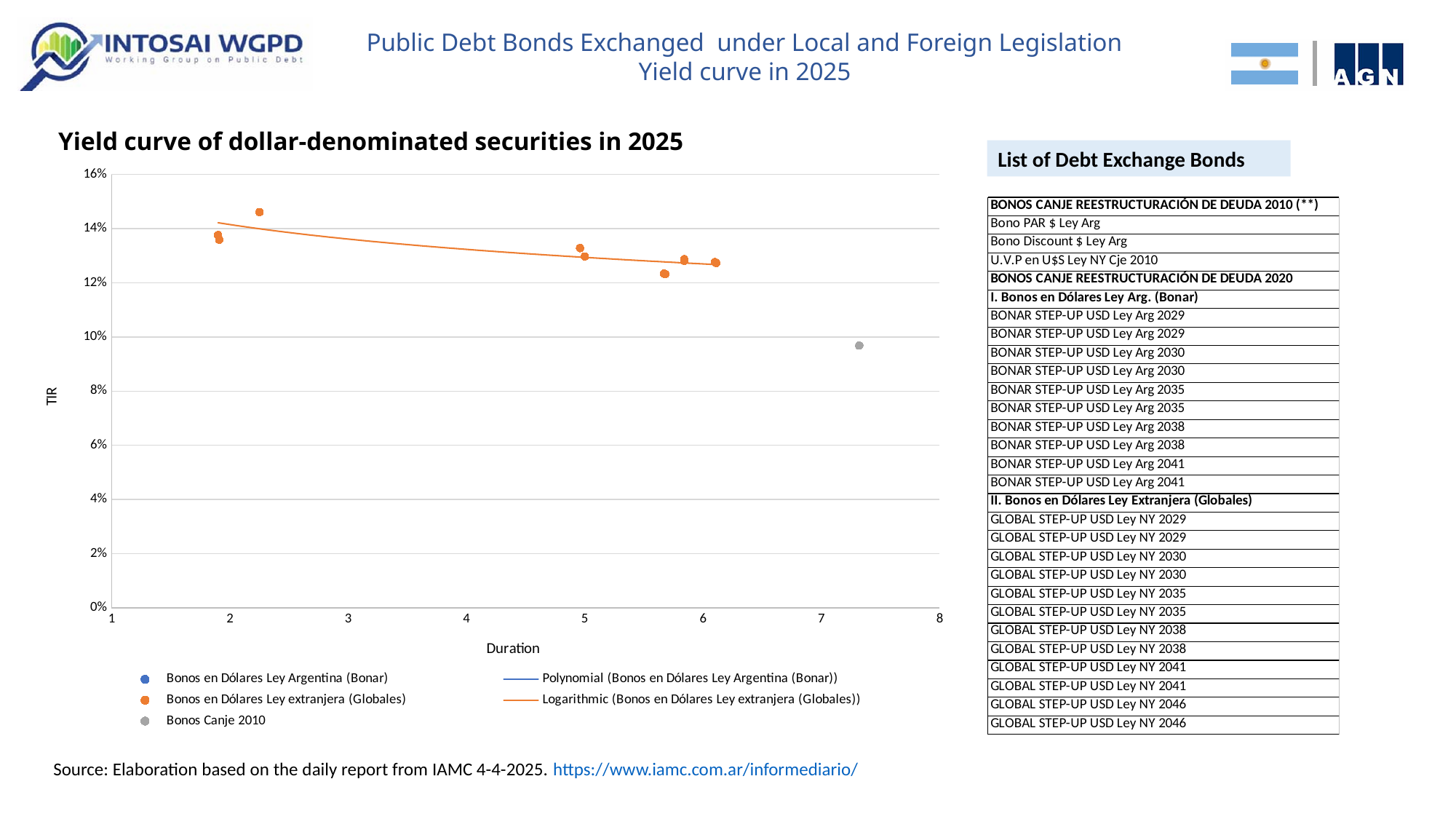
What colour are the Bonos en Dólares Ley extranjera (Globales) points in the chart? Orange Which has a higher TIR: the Bonos Canje 2010 point or the Bonos en Dólares Ley extranjera (Globales) points? Bonos en Dólares Ley extranjera (Globales) What is the title of the chart on the slide? Yield curve of dollar-denominated securities in 2025 Is the TIR value for the Bonos Canje 2010 point greater or less than 10%? less Does the logarithmic trendline for the Globales bonds rise or fall as duration increases? Fall How many Bonos Canje 2010 points are plotted on the chart? 1 What kind of chart is shown on the slide? Scatter chart Which series has the point with the longest duration on the chart? Bonos Canje 2010 Is the TIR value for the Bonos Canje 2010 point greater or less than 8%? greater How many entries does the chart's legend list? 5 Are the TIR values of the Bonos en Dólares Ley extranjera (Globales) points greater or less than 12%? greater